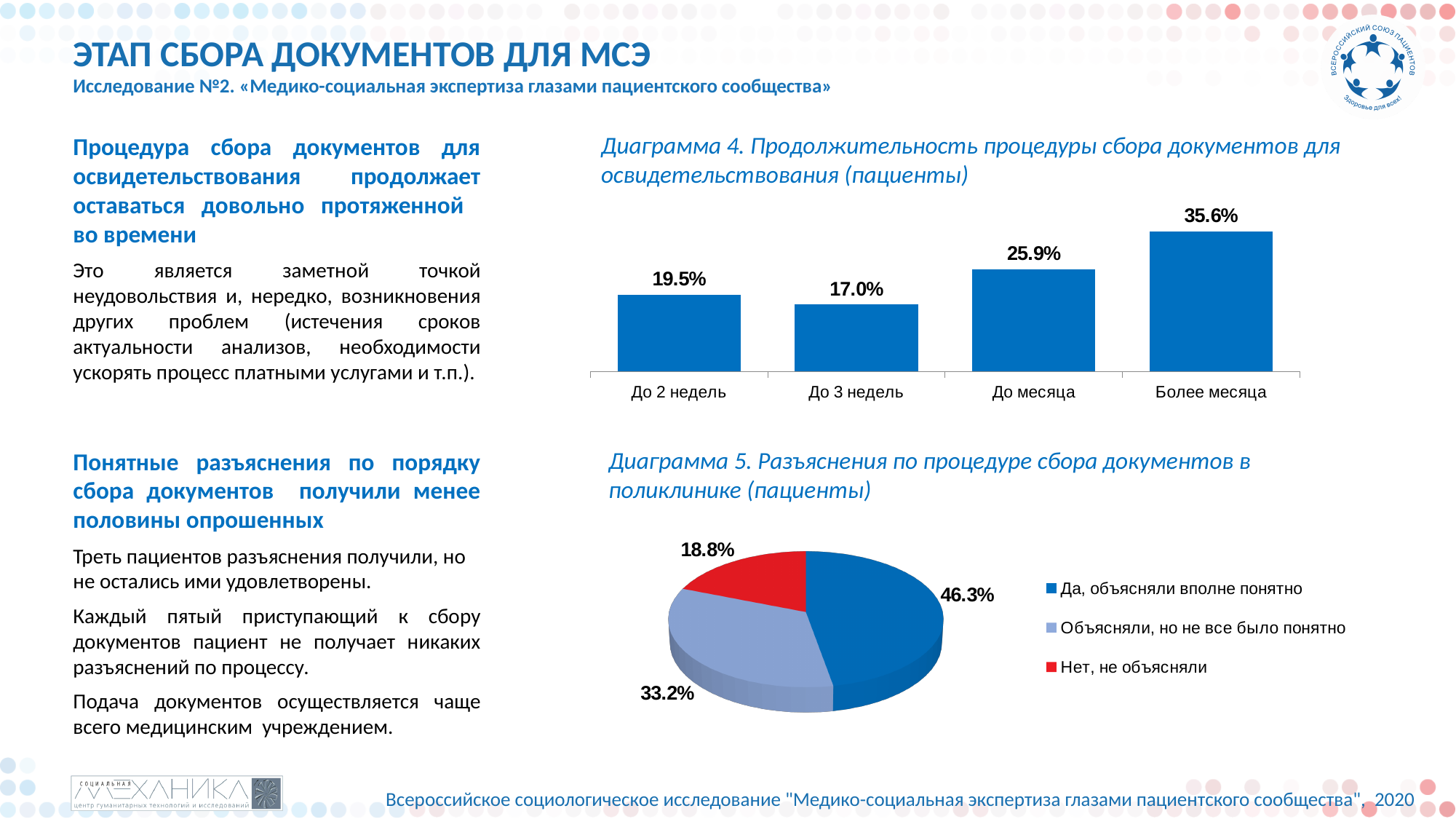
In Diagram 5, what is the value for «Объясняли, но не все было понятно»? 33.2% In Diagram 4, what is the value for «До 3 недель»? 17.0% In Diagram 4 (Продолжительность процедуры сбора документов), what is the value for «Более месяца»? 35.6% How many entries does the legend of Diagram 5 list? 3 What type of chart is Diagram 4? Bar chart In Diagram 4, which category has the lowest value? До 3 недель In Diagram 4, what is the difference between «Более месяца» and «До 3 недель»? 18.6% In Diagram 4, which is larger: «До 2 недель» or «До месяца»? До месяца In Diagram 4, which category has the highest value? Более месяца In Diagram 5, which slice is the largest? Да, объясняли вполне понятно In Diagram 5 (Разъяснения по процедуре сбора документов), what share is «Нет, не объясняли»? 18.8% How many categories are shown in Diagram 4? 4